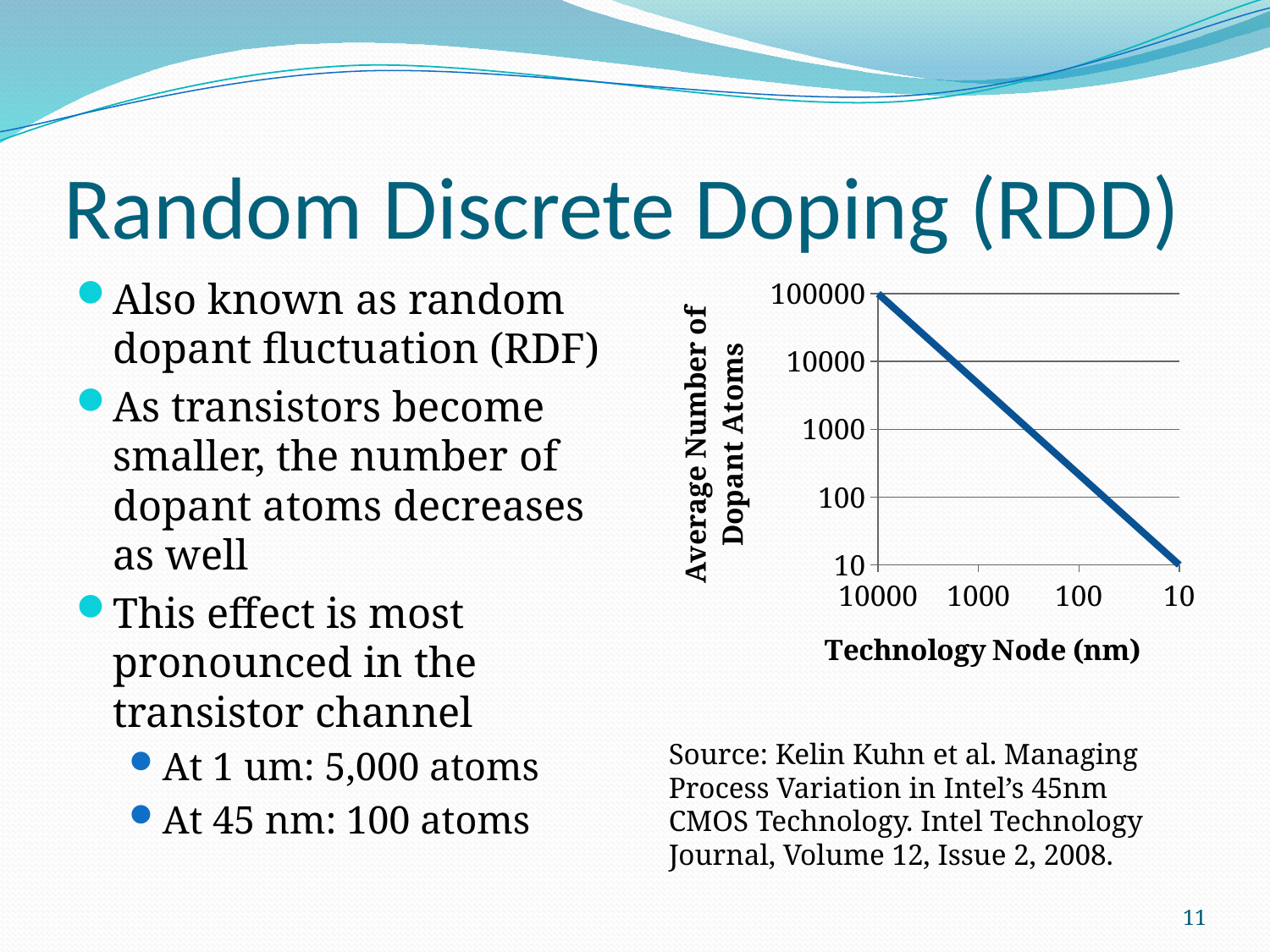
Do the values rise or fall moving left to right along the x axis? fall Which has more dopant atoms, the 1000 nm node or the 100 nm node? 1000 nm What is the title of the x axis of the chart? Technology Node (nm) Is the average number of dopant atoms at the 1000 nm technology node greater or less than 100000? less What is the average number of dopant atoms at the 10000 nm technology node? 100000 Is the average number of dopant atoms at the 100 nm technology node greater or less than 10000? less Is the average number of dopant atoms at the 100 nm technology node greater or less than 100? greater What is the average number of dopant atoms at the 10 nm technology node? 10 At which technology node shown on the x axis is the average number of dopant atoms lowest? 10 What is the title of the y axis of the chart? Average Number of Dopant Atoms What kind of chart is shown on the slide? line chart At which technology node shown on the x axis is the average number of dopant atoms highest? 10000